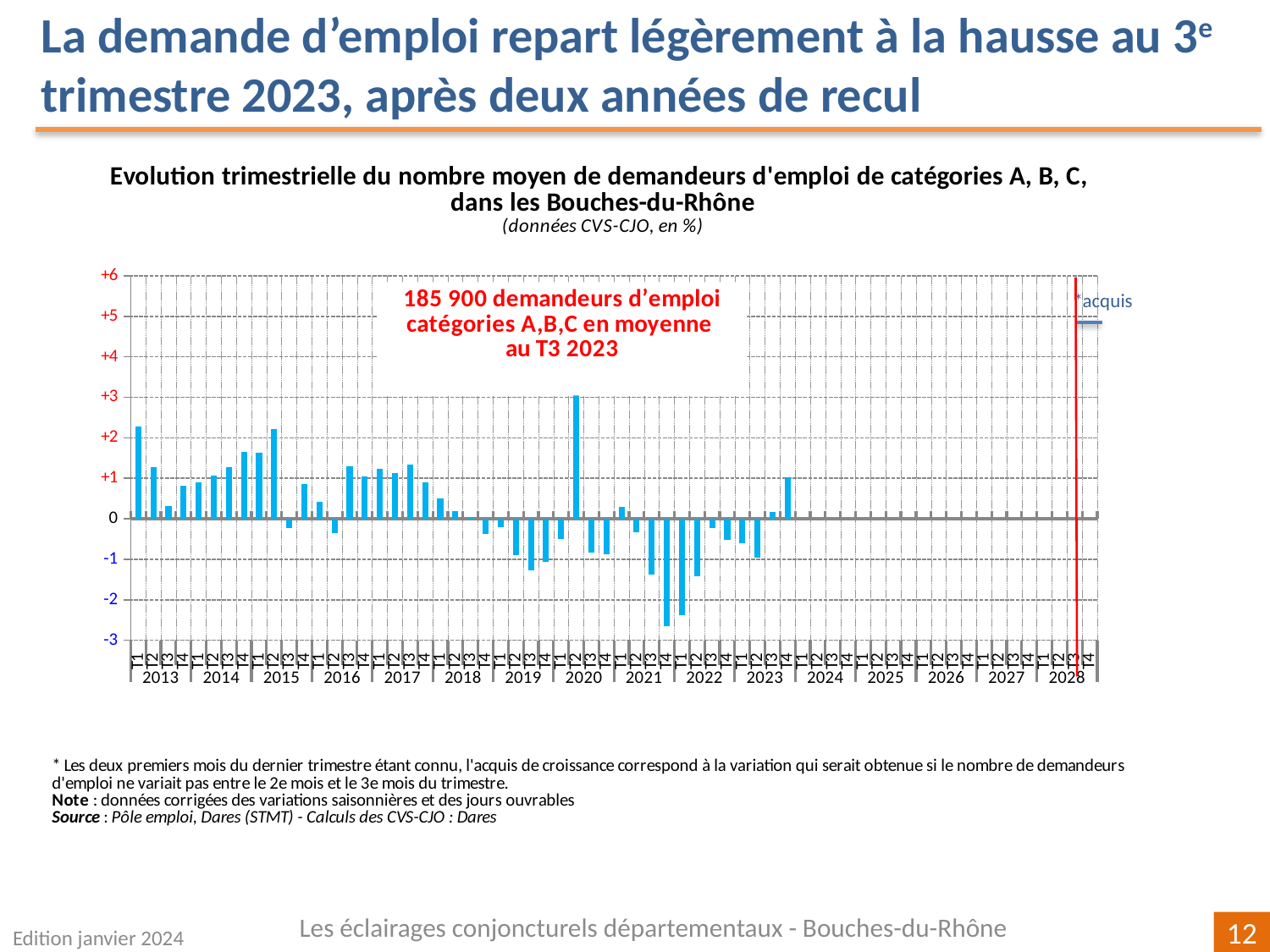
According to the annotation on the chart, how many job seekers in categories A, B, C were there on average in T3 2023? 185 900 Is the value for T2 2020 greater or less than +2? greater Is the value for T1 2013 greater or less than +2? greater Which is larger, the value for T2 2020 or the value for T1 2013? T2 2020 What is the highest tick value shown on the vertical axis? +6 Is the value for T1 2023 greater or less than 0? less In which quarter is the highest bar on the chart? T2 2020 In which year does the lowest bar on the chart occur? 2021 Which is larger, the value for T3 2019 or the value for T3 2021? T3 2019 What kind of chart is shown on the slide? bar chart